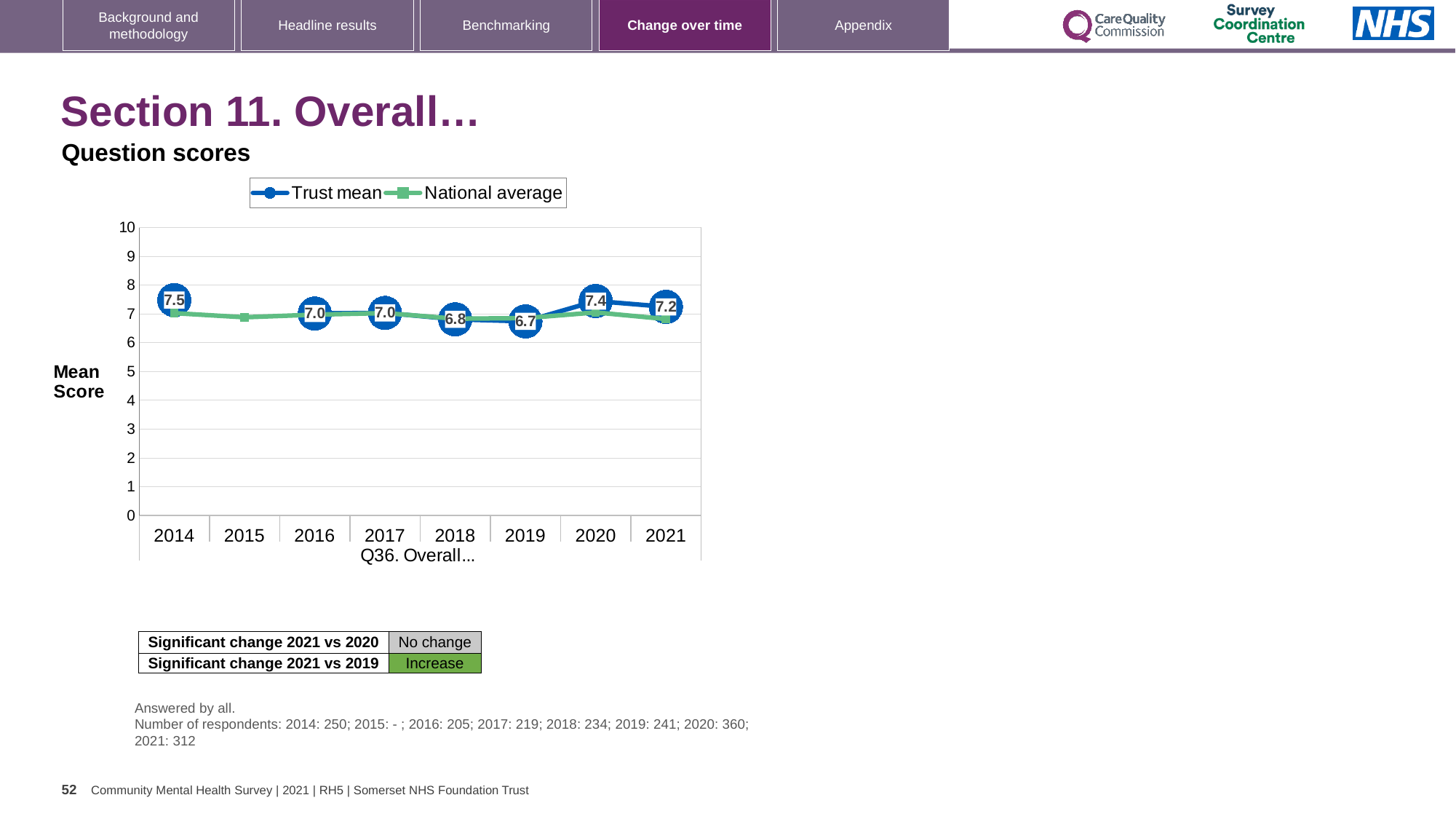
What is the Trust mean score for 2021? 7.2 What is the Trust mean score for 2014? 7.5 How many series does the chart legend list? 2 How many years are shown on the x axis of the chart? 8 What is the Trust mean score for 2018? 6.8 What kind of chart is shown on the slide? line chart In which year is the Trust mean score highest? 2014 Which year has the larger Trust mean score, 2020 or 2018? 2020 Is the National average value for 2015 greater or less than 5? greater In which year is the Trust mean score lowest? 2019 Does the Trust mean score rise or fall from 2019 to 2020? rise What is the difference between the Trust mean score in 2021 and in 2019? 0.5